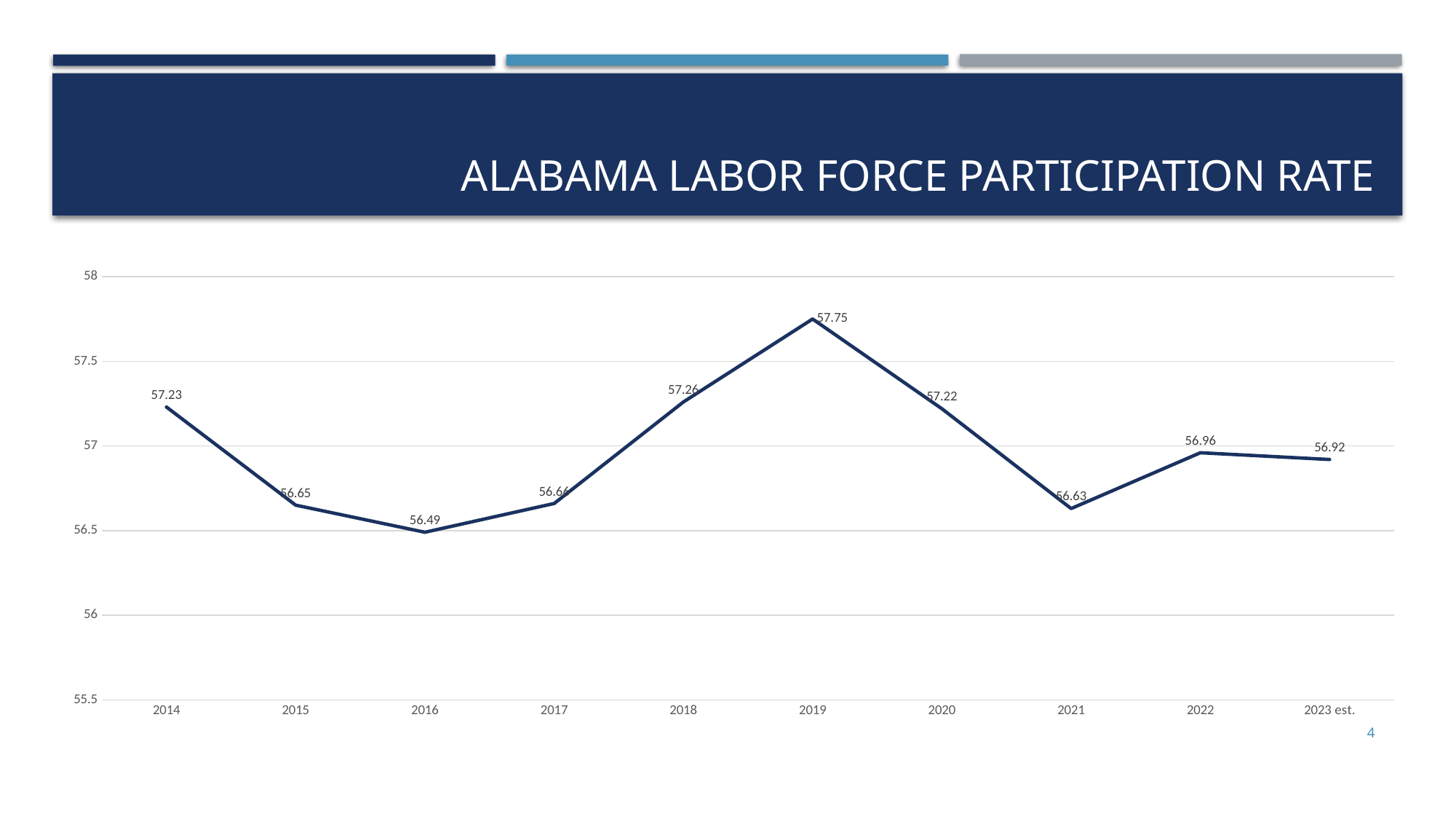
Is the value for 2021 greater or less than 57? less What is the difference between the 2014 value and the 2015 value? 0.58 What is the labor force participation rate for 2019? 57.75 Does the labor force participation rate rise or fall from 2019 to 2021? fall What is the difference between the 2019 value and the 2016 value? 1.26 What is the labor force participation rate for 2016? 56.49 Which year has the highest labor force participation rate? 2019 What kind of chart is shown on the slide? line chart Which is larger, the value for 2018 or the value for 2020? 2018 What is the value shown for 2023 est.? 56.92 Which year has the lowest labor force participation rate? 2016 How many years are plotted on the chart? 10